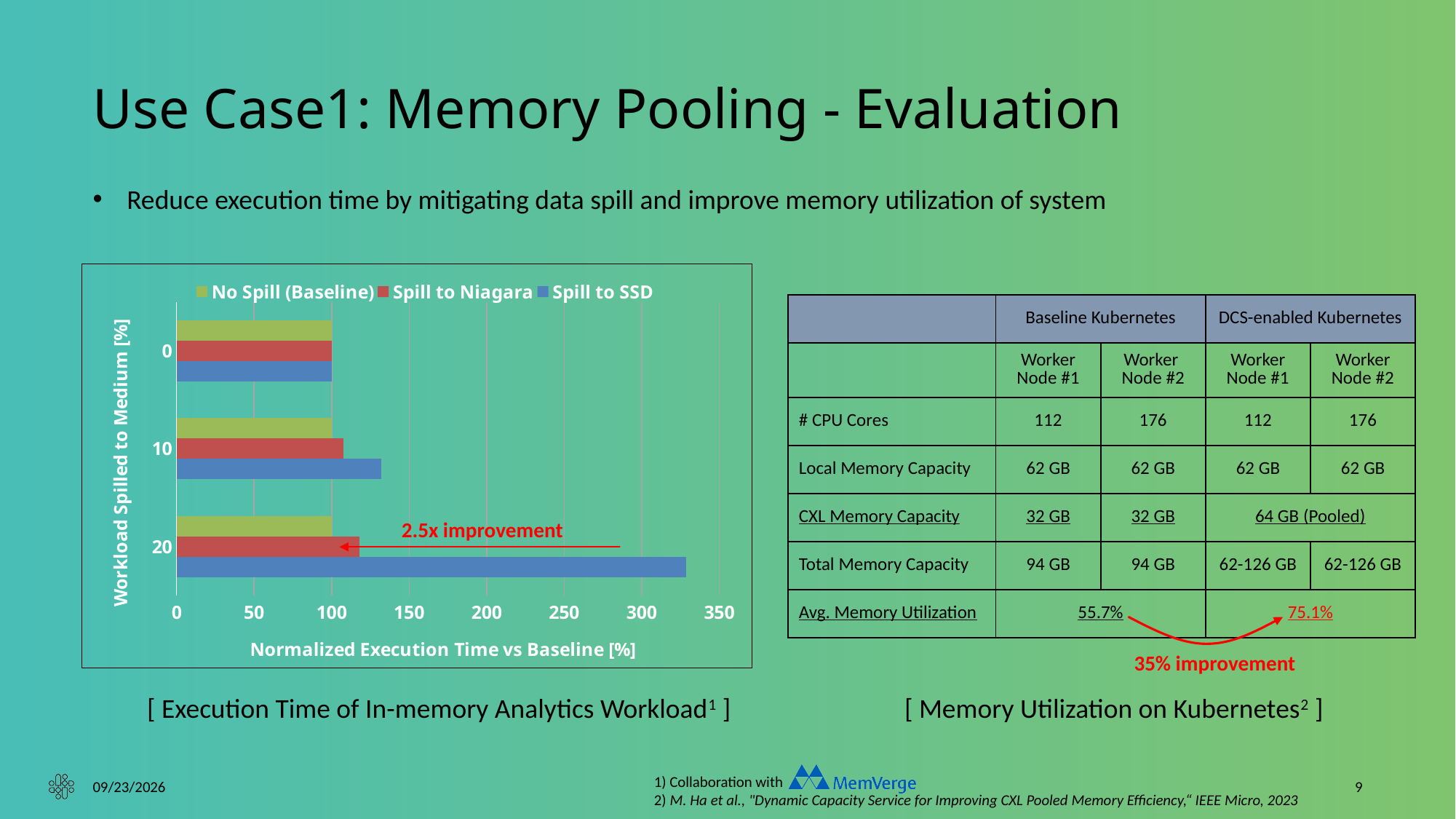
Is the Spill to SSD value at 10% workload spilled greater or less than 150? less What is the title of the chart's horizontal axis? Normalized Execution Time vs Baseline [%] Is the Spill to Niagara value at 20% workload spilled greater or less than 150? less At 20% workload spilled, which is larger: Spill to Niagara or Spill to SSD? Spill to SSD What kind of chart is shown on the slide? bar chart Does the Spill to SSD value rise or fall as the workload spilled to medium increases from 0 to 20? rise How many workload categories are shown on the y axis of the chart? 3 Is the Spill to SSD value at 20% workload spilled greater or less than 300? greater How many series does the chart's legend list? 3 At 10% workload spilled, which is larger: No Spill (Baseline) or Spill to SSD? Spill to SSD What improvement factor is annotated on the chart next to the 20% workload bars? 2.5x improvement Which series has the longest bar in the chart? Spill to SSD